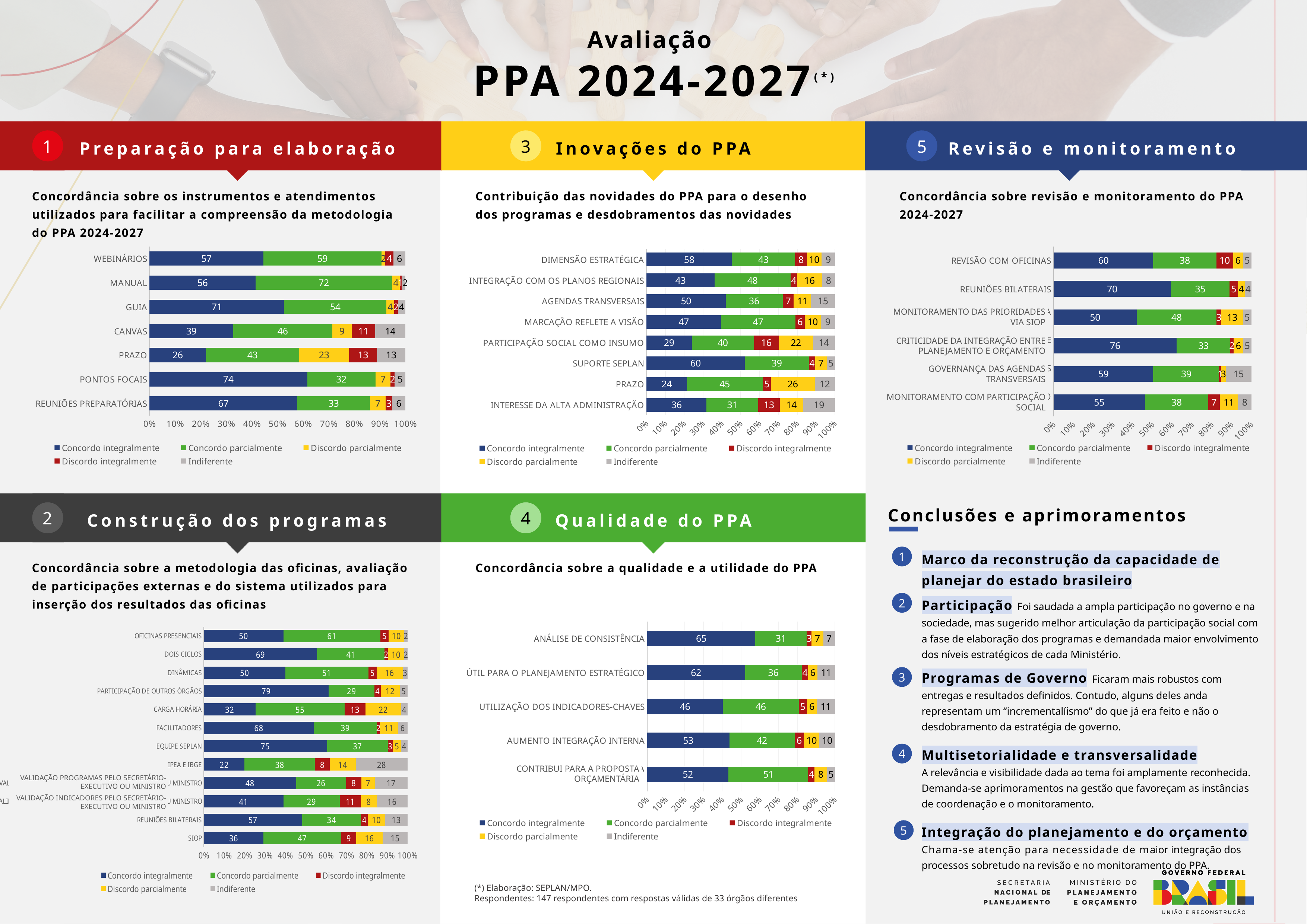
In the 'Preparação para elaboração' chart, what is the 'Concordo integralmente' value for PONTOS FOCAIS? 74 In the 'Inovações do PPA' chart, which category has the lowest 'Concordo integralmente' value? PRAZO In the 'Preparação para elaboração' chart, what is the difference between the 'Concordo integralmente' values for GUIA and PRAZO? 45 In the 'Inovações do PPA' chart, what is the 'Discordo parcialmente' value for PRAZO? 26 In the 'Revisão e monitoramento' chart, what is the 'Concordo integralmente' value for CRITICIDADE DA INTEGRAÇÃO ENTRE PLANEJAMENTO E ORÇAMENTO? 76 In the 'Revisão e monitoramento' chart, which is larger: the 'Indiferente' value for GOVERNANÇA DAS AGENDAS TRANSVERSAIS or for REUNIÕES BILATERAIS? GOVERNANÇA DAS AGENDAS TRANSVERSAIS In the 'Qualidade do PPA' chart, what is the 'Concordo integralmente' value for ANÁLISE DE CONSISTÊNCIA? 65 In the 'Preparação para elaboração' chart, which category has the highest 'Concordo parcialmente' value? MANUAL In the 'Construção dos programas' chart, what is the 'Indiferente' value for IPEA E IBGE? 28 What type of chart is used in the 'Construção dos programas' section? Stacked bar chart In the 'Inovações do PPA' chart, how many categories are plotted? 8 In the 'Qualidade do PPA' chart, how many series does the legend list? 5